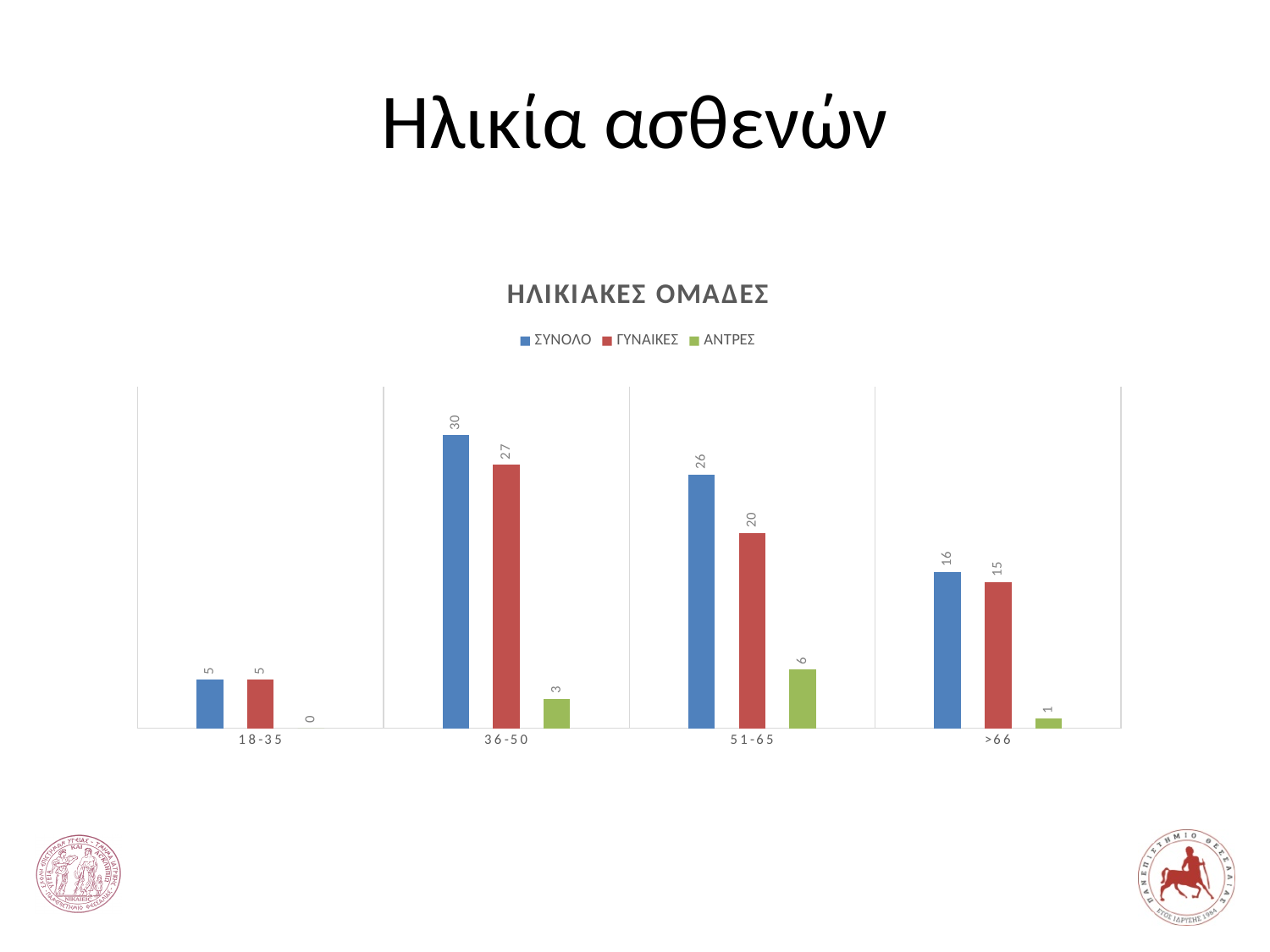
Which age group has the highest ΣΥΝΟΛΟ value? 36-50 What is the value for ΣΥΝΟΛΟ in the 36-50 age group? 30 What is the difference between the ΣΥΝΟΛΟ and ΓΥΝΑΙΚΕΣ values in the 51-65 age group? 6 How many age groups are shown on the x axis? 4 What is the value for ΓΥΝΑΙΚΕΣ in the 51-65 age group? 20 What is the title of the chart? ΗΛΙΚΙΑΚΕΣ ΟΜΑΔΕΣ What kind of chart is shown on the slide? bar chart Which age group has the lowest ΓΥΝΑΙΚΕΣ value? 18-35 How many series does the legend list? 3 What is the value for ΑΝΤΡΕΣ in the 18-35 age group? 0 What is the value for ΑΝΤΡΕΣ in the >66 age group? 1 Which is larger: ΑΝΤΡΕΣ in the 51-65 group or ΑΝΤΡΕΣ in the 36-50 group? 51-65